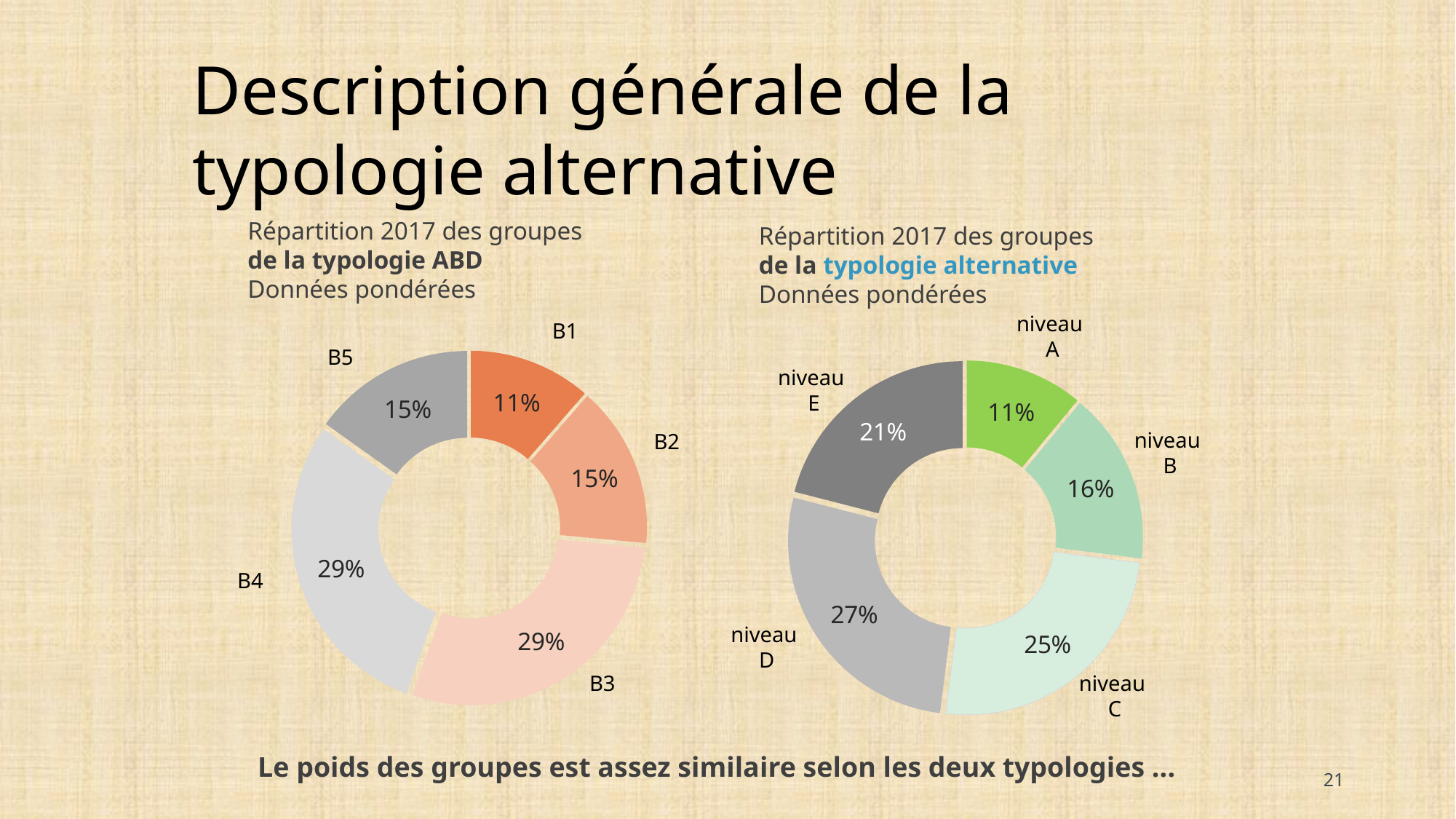
In the right chart (typologie alternative), which niveau has the largest share? niveau D In the right chart (typologie alternative), what colour is the niveau A segment? Green In the right chart (typologie alternative), what is the share for niveau E? 21% How many groups are shown in the left chart (typologie ABD)? 5 What kind of chart is used on the right for the typologie alternative? Doughnut (pie) chart In the left chart (typologie ABD), what is the share for B3? 29% In the left chart (typologie ABD), which is larger, the share of B2 or the share of B4? B4 In the left chart (typologie ABD), what is the share for B1? 11% In the right chart (typologie alternative), what is the difference between the shares of niveau D and niveau B? 11% In the right chart (typologie alternative), what is the share for niveau C? 25% In the left chart (typologie ABD), which group has the smallest share? B1 In the right chart (typologie alternative), which niveau has the smallest share? niveau A